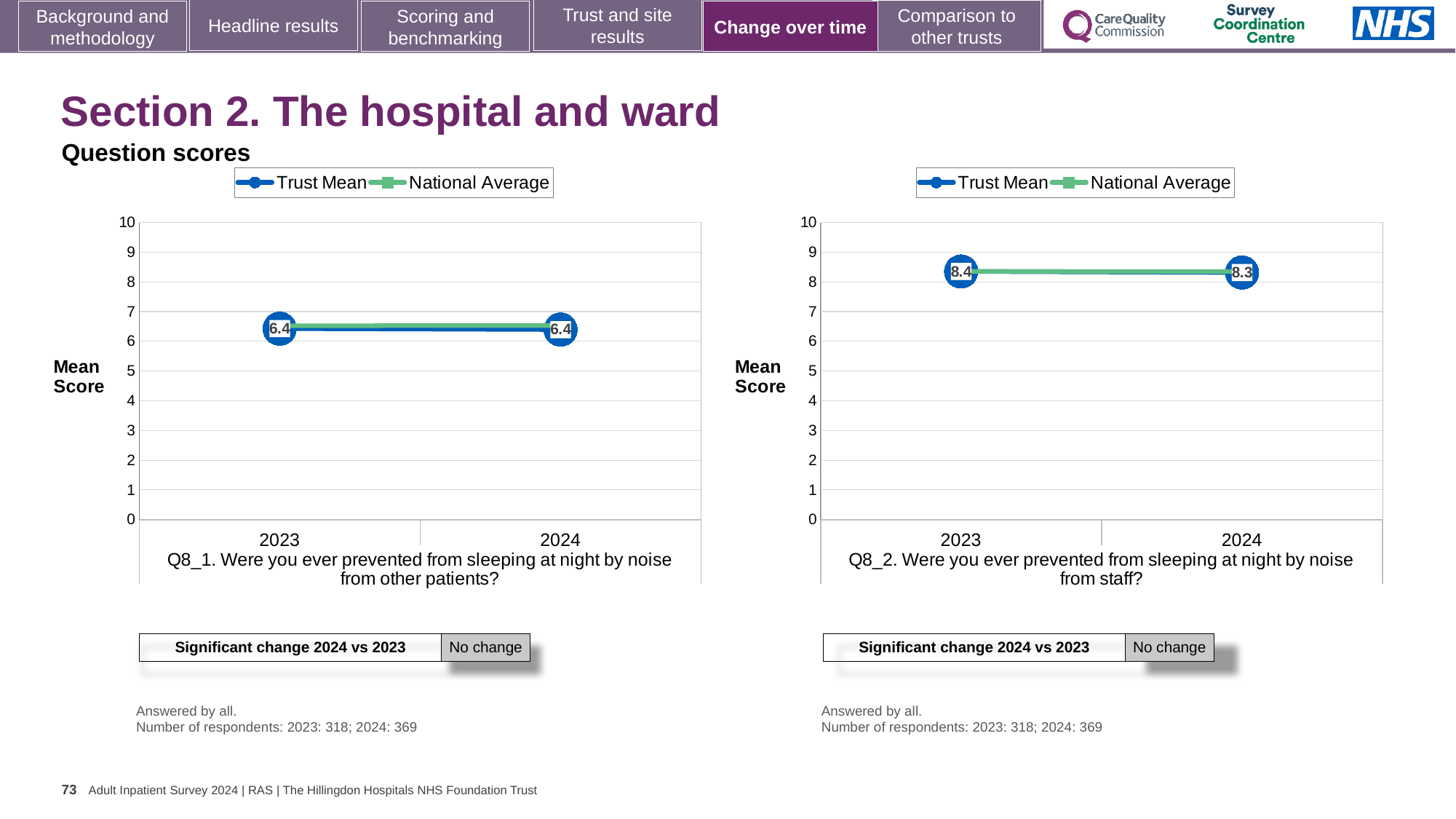
On the left chart (Q8_1), is the Trust Mean for 2024 greater or less than 7? less On the right chart (Q8_2), what is the Trust Mean score for 2023? 8.4 How many series does the legend of the left chart (Q8_1) list? 2 On the right chart (Q8_2), is the Trust Mean for 2023 greater or less than 8? greater How many years are plotted on the x axis of the right chart (Q8_2)? 2 On the right chart (Q8_2), does the Trust Mean rise or fall from 2023 to 2024? fall On the right chart (Q8_2), what is the Trust Mean score for 2024? 8.3 On the left chart (Q8_1), what is the Trust Mean score for 2023? 6.4 What kind of chart is the left chart (Q8_1)? line chart On the right chart (Q8_2), what is the difference between the Trust Mean scores for 2023 and 2024? 0.1 What are the two series named in the legend of the right chart (Q8_2)? Trust Mean and National Average On the left chart (Q8_1), what is the Trust Mean score for 2024? 6.4